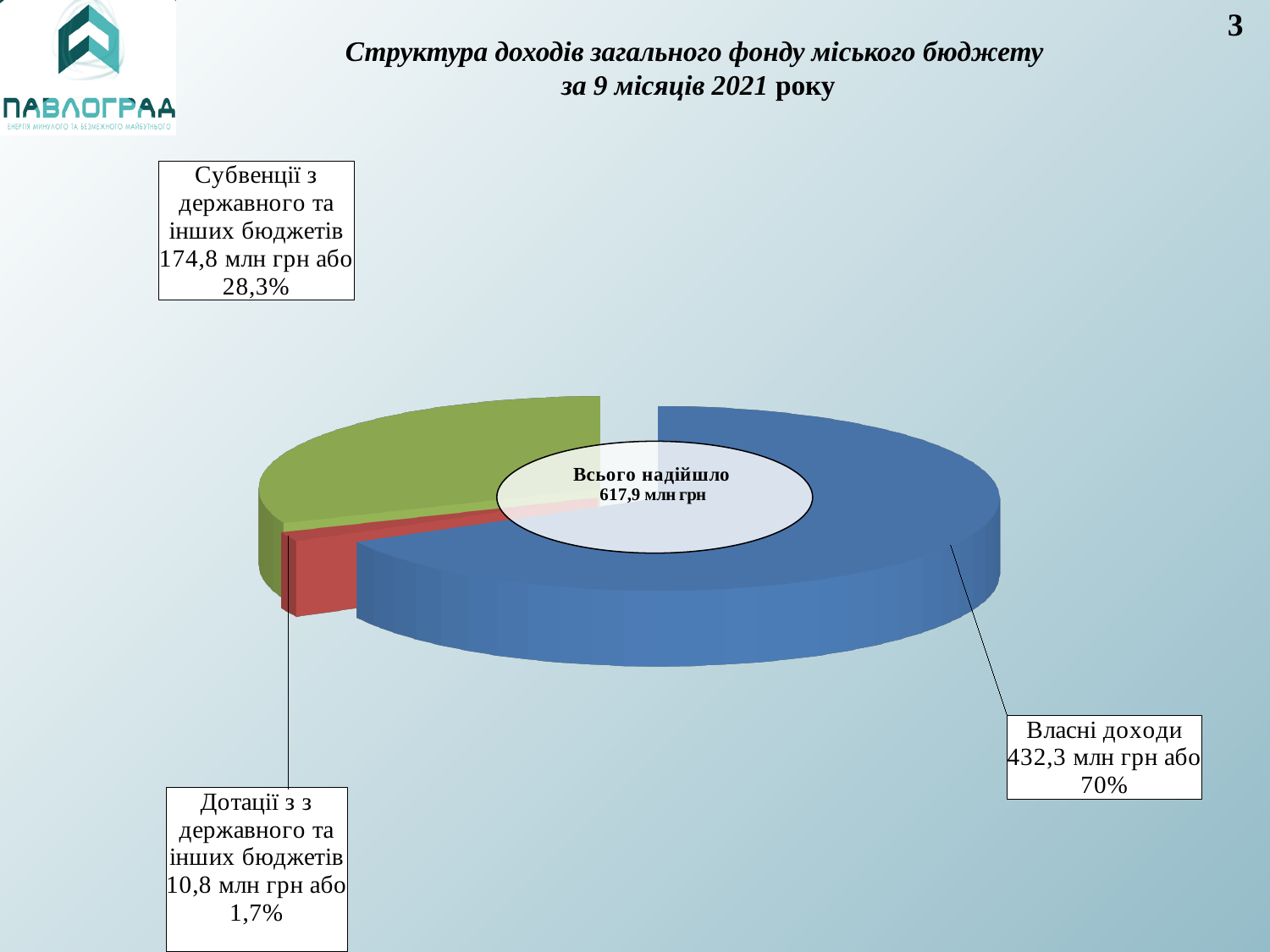
What is the value for Власні доходи? 432,3 млн грн What is the value for Дотації з державного та інших бюджетів? 10,8 млн грн What total amount is shown in the centre of the pie chart? 617,9 млн грн What share of the pie is Власні доходи? 70% What kind of chart is shown on the slide? Pie chart How many slices does the pie chart have? 3 What share of the pie is Дотації з державного та інших бюджетів? 1,7% Which category has the largest slice of the pie? Власні доходи Which category has the smallest slice of the pie? Дотації з державного та інших бюджетів What share of the pie is Субвенції з державного та інших бюджетів? 28,3% What is the value for Субвенції з державного та інших бюджетів? 174,8 млн грн What is the difference in млн грн between Власні доходи and Субвенції з державного та інших бюджетів? 257,5 млн грн